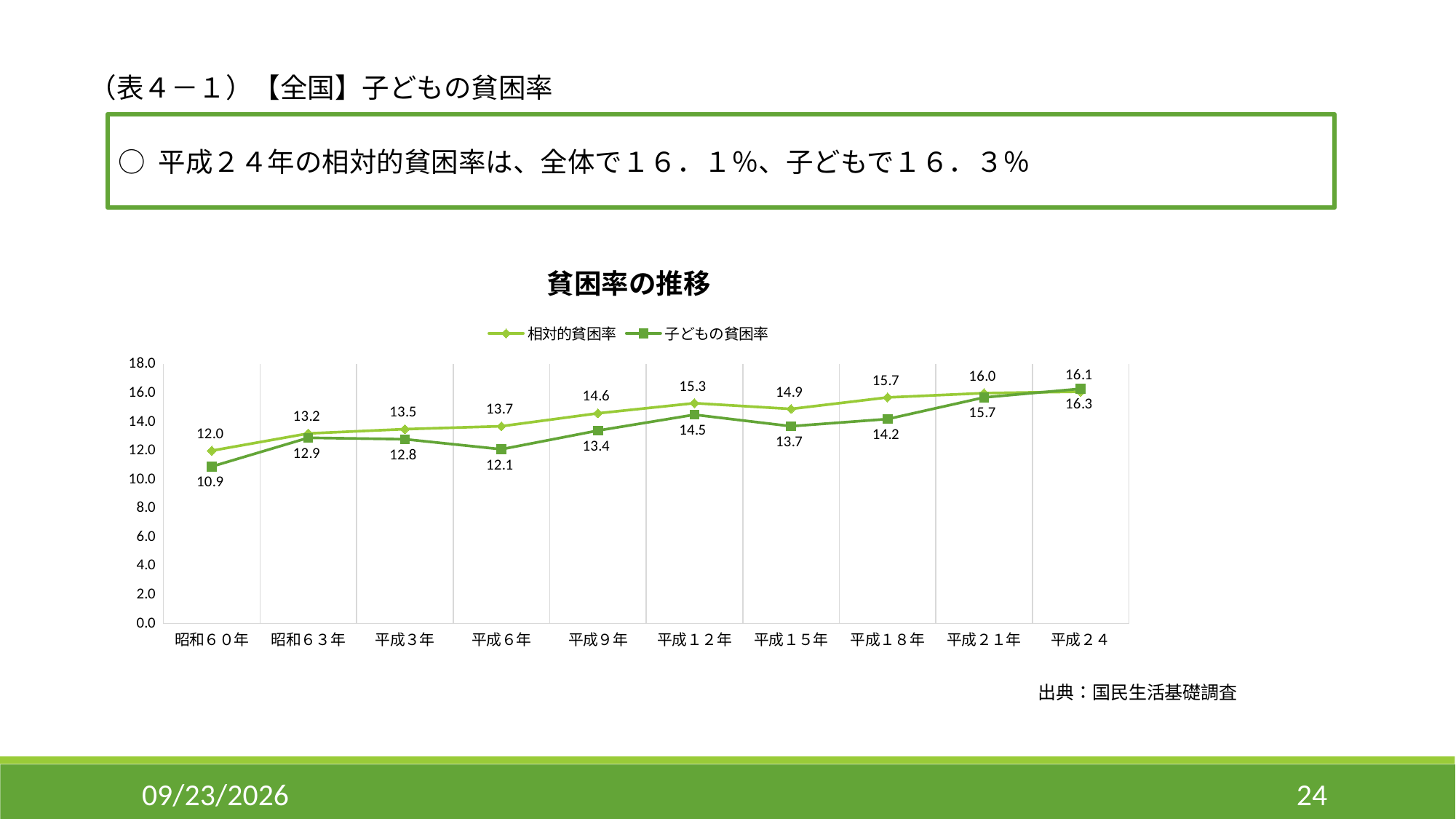
Which category has the highest value for 相対的貧困率? 平成２４ Which category has the lowest value for 子どもの貧困率? 昭和６０年 Does 相対的貧困率 generally rise or fall from 昭和６０年 to 平成２４? rise What is the value of 子どもの貧困率 for 昭和６０年? 10.9 What is the value of 子どもの貧困率 for 平成２４? 16.3 What is the value of 相対的貧困率 for 平成１２年? 15.3 What kind of chart is shown? line chart How many series does the legend list? 2 How many categories are shown on the x axis? 10 Which is larger for 平成１５年: 相対的貧困率 or 子どもの貧困率? 相対的貧困率 What is the title of the chart? 貧困率の推移 What is the difference between 相対的貧困率 and 子どもの貧困率 for 平成６年? 1.6